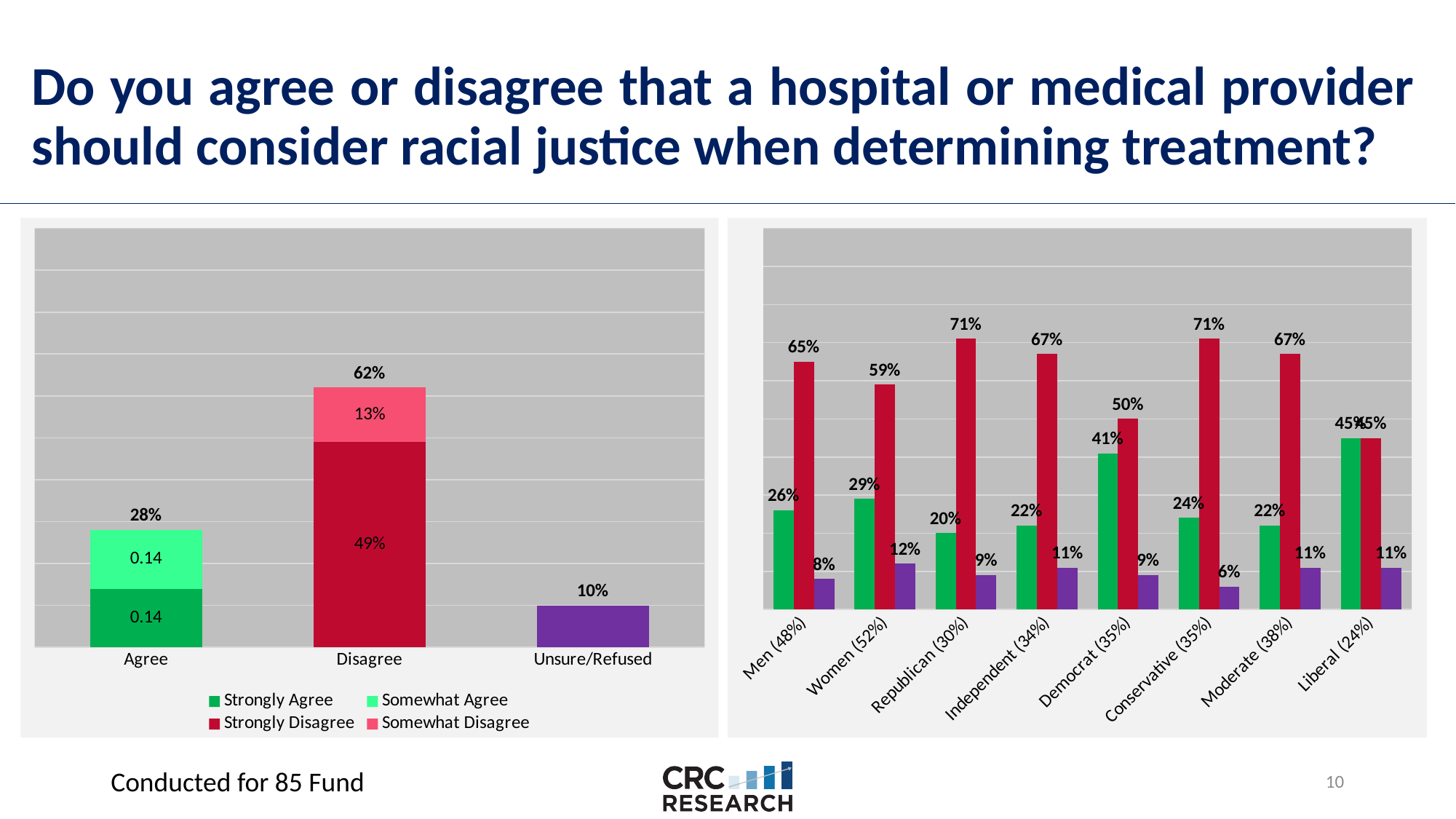
In the right chart, which category has the lowest purple bar? Conservative (35%) In the right chart, what is the value of the red bar for Republican (30%)? 71% What kind of chart is the left chart? Stacked bar chart In the right chart, is the red bar for Men (48%) larger or smaller than the red bar for Women (52%)? Larger In the left chart, what is the total value shown for the Disagree bar? 62% In the left chart, what is the value shown for Unsure/Refused? 10% In the left chart, how many series does the legend list? 4 In the left chart, what is the value of the Somewhat Disagree segment of the Disagree bar? 13% In the right chart, how many categories are shown on the x axis? 8 In the right chart, which category has the highest green bar? Liberal (24%) In the left chart, what is the difference between the Disagree total and the Agree total? 34% In the right chart, what is the value of the green bar for Democrat (35%)? 41%